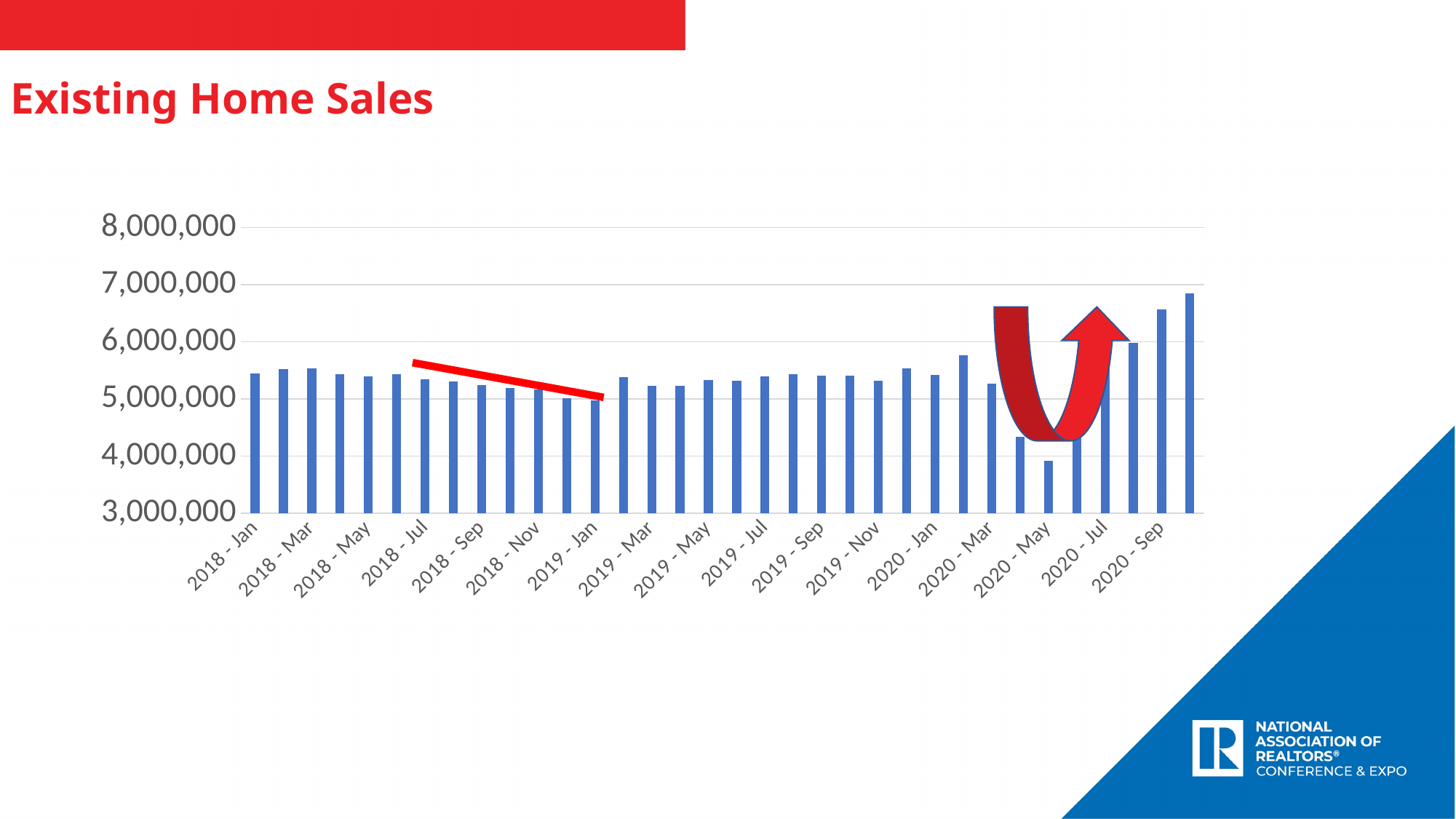
What is the title of the slide's chart? Existing Home Sales What is the lowest value shown on the vertical axis? 3,000,000 Is the value for 2020 - Sep greater or less than 6,000,000? greater Which month has the lowest existing home sales in the chart? 2020 - May Which is larger, the value for 2019 - May or the value for 2020 - May? 2019 - May Is the value for 2018 - Jan greater or less than 5,000,000? greater How many bars are plotted in the chart? 34 Which is larger, the value for 2020 - Sep or the value for 2018 - Jan? 2020 - Sep Is the value for 2020 - Jul greater or less than 5,000,000? greater What kind of chart is shown on the slide? bar chart Do the values rise or fall from 2020 - May to 2020 - Sep? rise